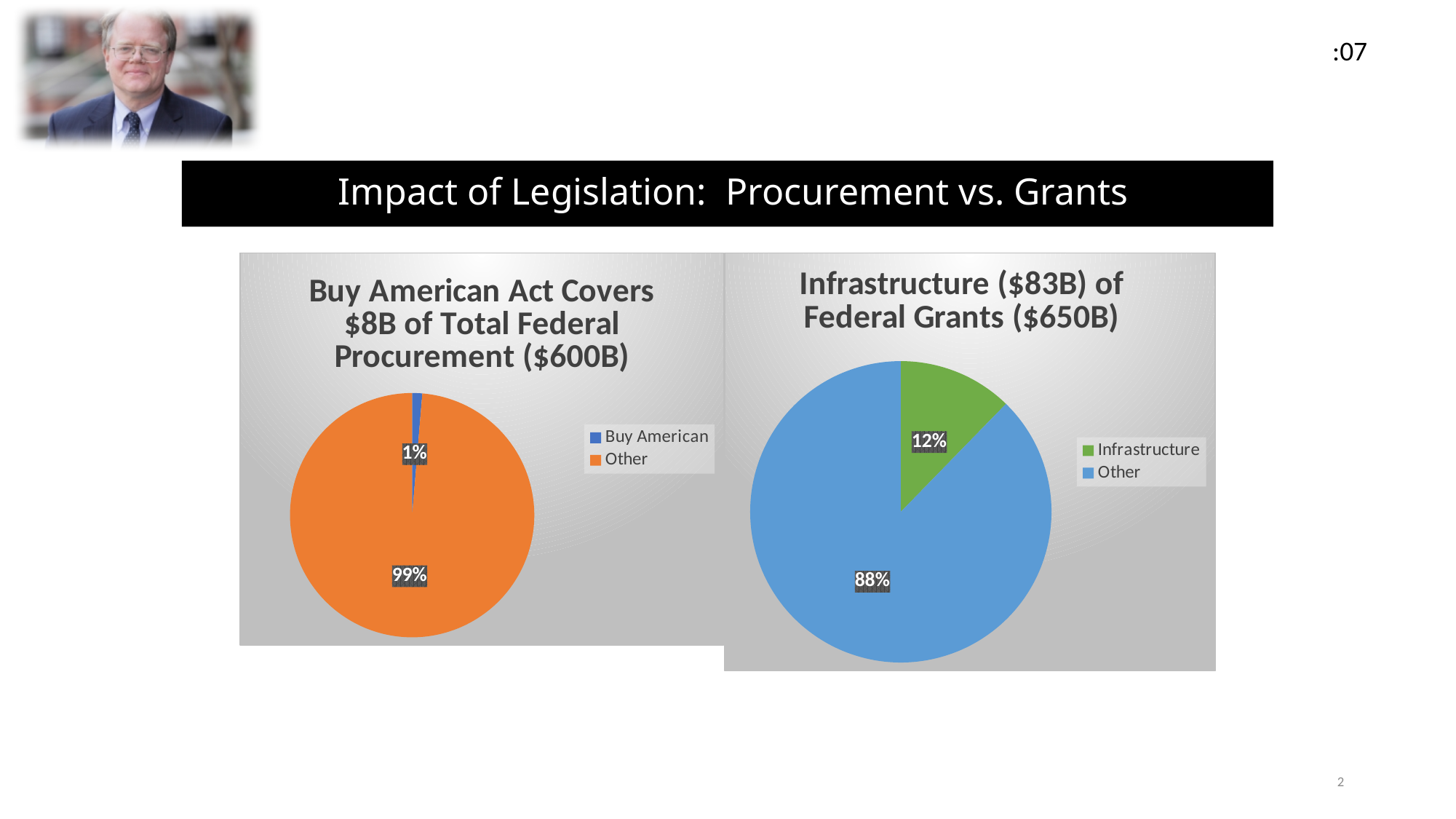
In the right pie chart (Infrastructure ($83B) of Federal Grants ($650B)), what share does the Infrastructure slice have? 12% In the left pie chart, which slice is the largest? Other In the left pie chart (Buy American Act Covers $8B of Total Federal Procurement ($600B)), what share does the Buy American slice have? 1% How many entries does the legend of the left pie chart list? 2 In the right pie chart, which is larger, the Infrastructure slice or the Other slice? Other In the left pie chart (Buy American Act Covers $8B of Total Federal Procurement ($600B)), what share does the Other slice have? 99% What kind of chart is the left chart on the slide? Pie chart In the right pie chart, what is the difference in percentage points between the Other slice and the Infrastructure slice? 76 What colour is the Infrastructure slice in the right pie chart? Green In the right pie chart, which slice is the smallest? Infrastructure How many slices does the right pie chart have? 2